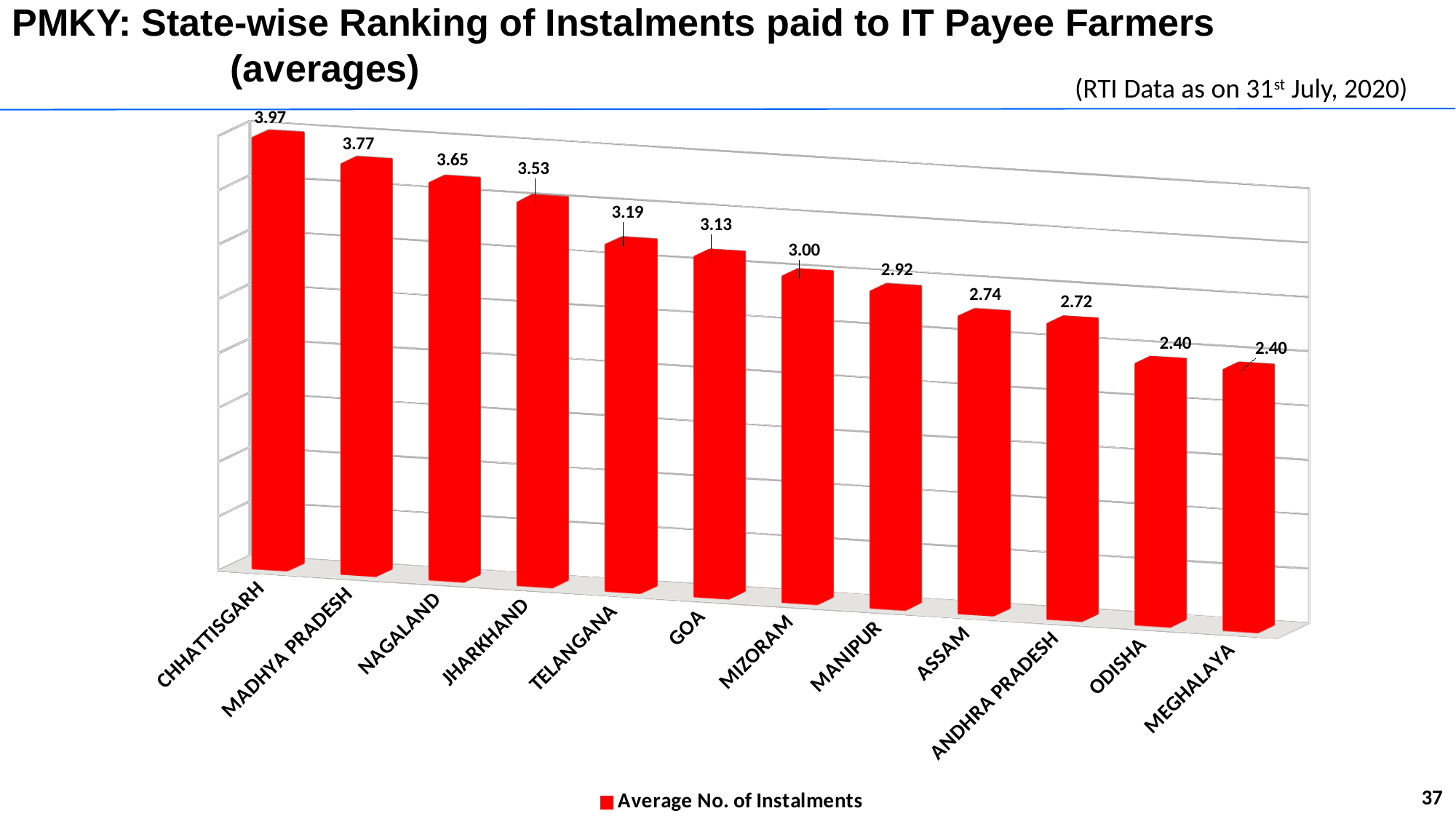
How many series does the legend list? 1 Which has a larger value, Mizoram or Manipur? Mizoram How many states are shown in the chart? 12 What is the difference between the values for Chhattisgarh and Meghalaya? 1.57 What is the difference between the values for Madhya Pradesh and Nagaland? 0.12 What kind of chart is shown on the slide? Bar chart Do the values rise or fall from left to right along the x axis? Fall What is the average number of instalments for Goa? 3.13 What is the average number of instalments for Chhattisgarh? 3.97 Which has a larger value, Jharkhand or Telangana? Jharkhand Which state has the highest average number of instalments? Chhattisgarh What is the average number of instalments for Andhra Pradesh? 2.72